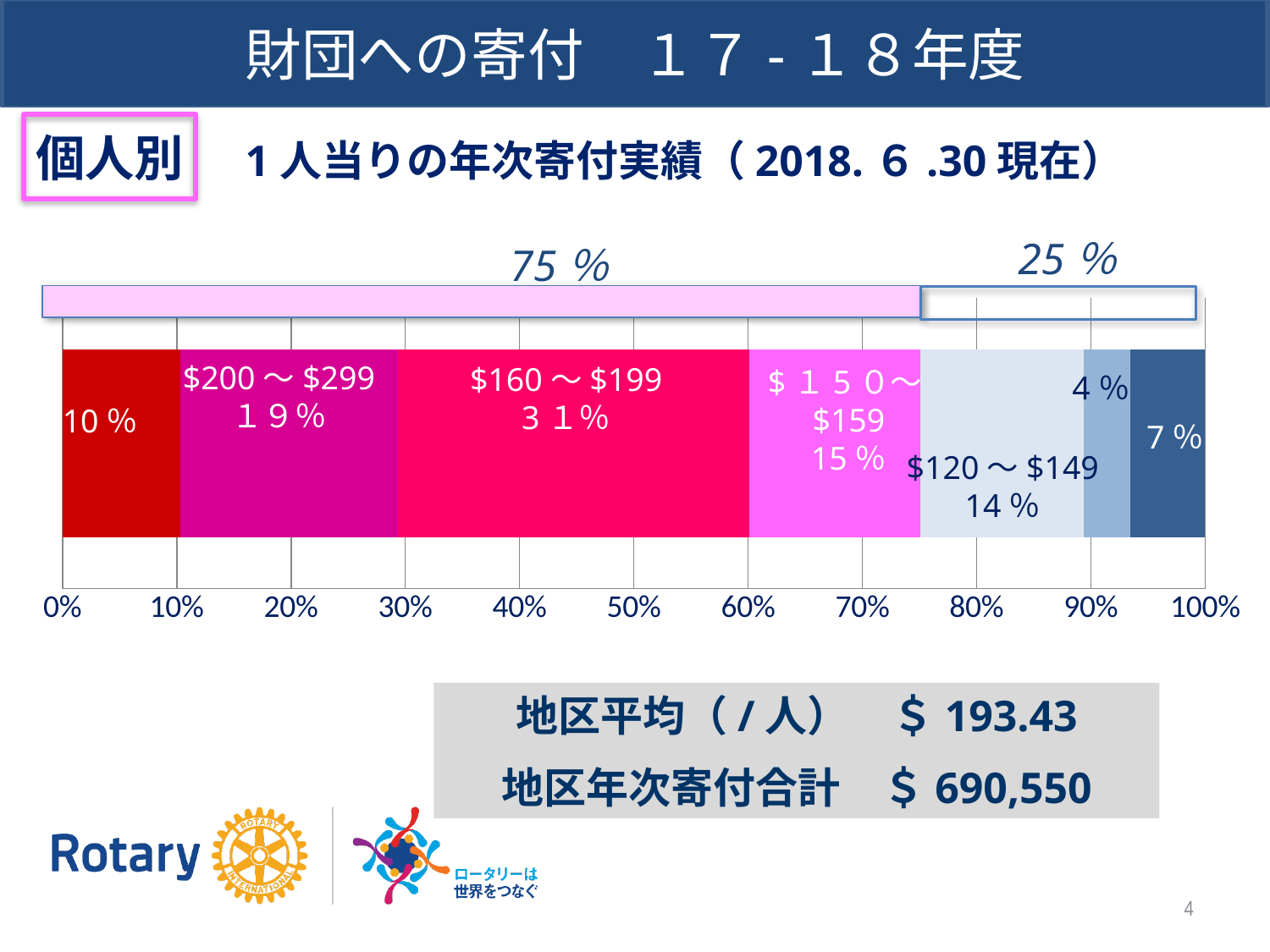
What share of members is covered by the pink bracket above the bar (the first four segments combined)? 75% What percentage of members donated $200〜$299 per person? 19% What percentage of members donated $120〜$149 per person? 14% What percentage of members donated $150〜$159 per person? 15% What kind of chart is shown on the slide? Stacked bar chart What is the district average donation per person shown below the chart? $ 193.43 How many percentage points larger is the $160〜$199 segment than the $200〜$299 segment? 12 percentage points What percentage of members donated $160〜$199 per person? 31% Which segment is larger, $200〜$299 or $120〜$149? $200〜$299 Which donation range has the largest share of members? $160〜$199 How many segments make up the stacked bar? 7 What is the smallest percentage shown on any segment of the bar? 4%